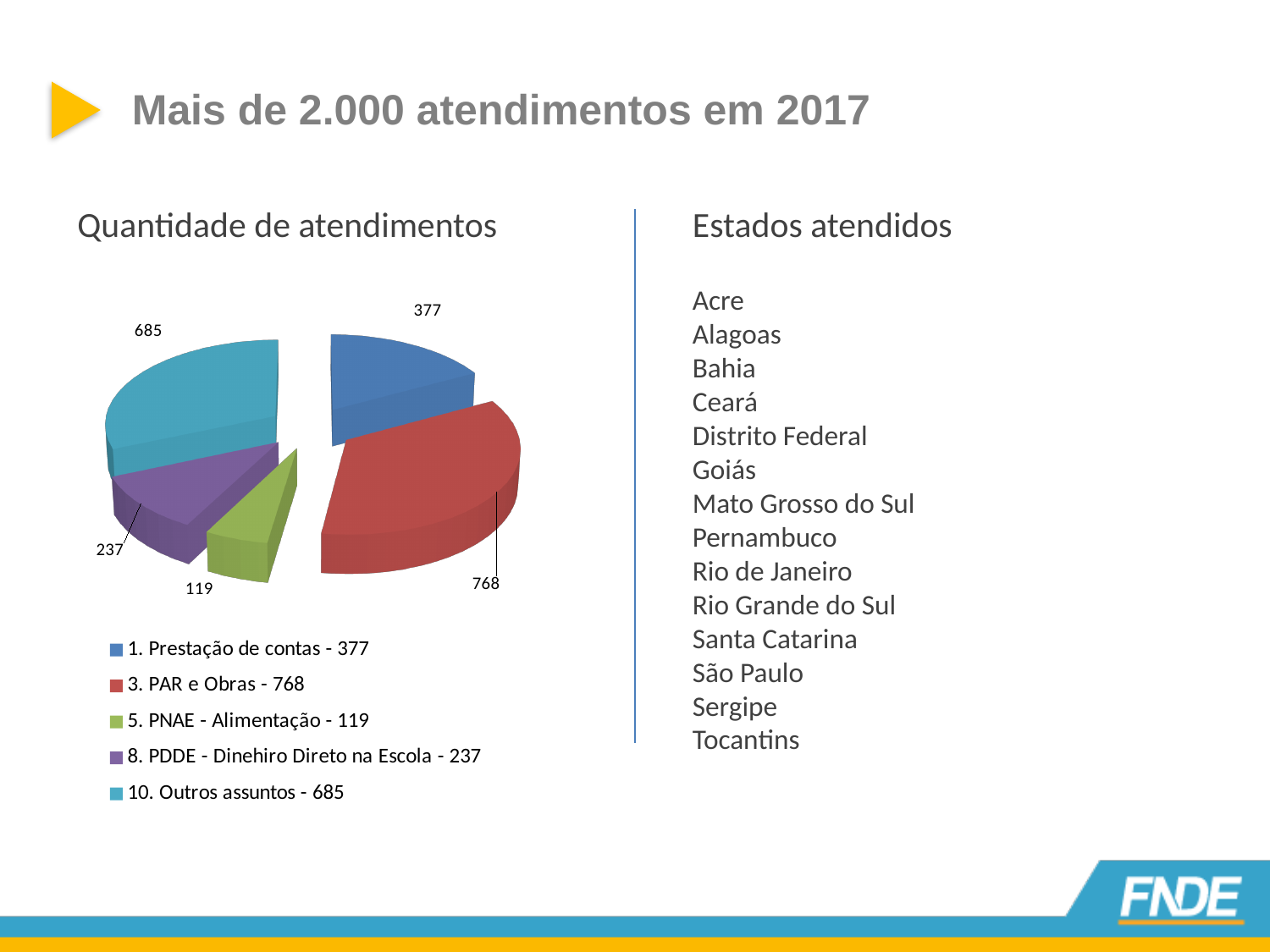
What is the value for "8. PDDE - Dinehiro Direto na Escola" in the pie chart? 237 What colour is the slice for "10. Outros assuntos" in the pie chart? Teal How many entries does the legend of the pie chart list? 5 What is the value for "3. PAR e Obras" in the pie chart? 768 Which category has the smallest slice in the pie chart? 5. PNAE - Alimentação What kind of chart is shown under the heading "Quantidade de atendimentos"? Pie chart Which category has the largest slice in the pie chart? 3. PAR e Obras What is the difference between the values for "3. PAR e Obras" and "10. Outros assuntos"? 83 Which is larger in the pie chart: "1. Prestação de contas" or "8. PDDE - Dinehiro Direto na Escola"? 1. Prestação de contas What is the value for "5. PNAE - Alimentação" in the pie chart? 119 What is the total of all the values shown in the pie chart? 2186 How many slices does the pie chart have? 5